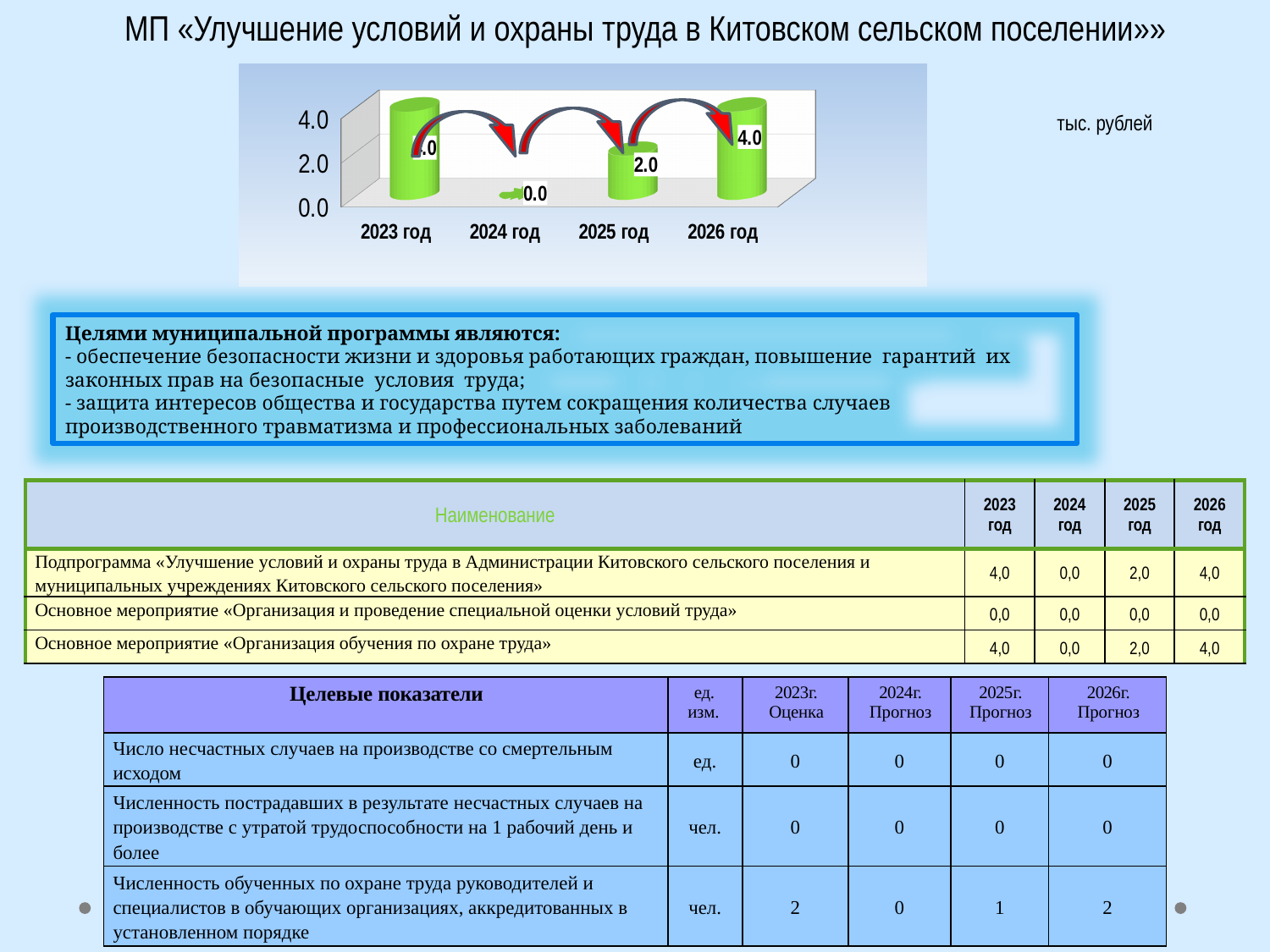
Which is larger, the value for 2025 год or the value for 2026 год? 2026 год What is the value for 2025 год on the chart? 2.0 How many years (categories) are plotted on the chart? 4 What is the value for 2026 год on the chart? 4.0 Which year has the lowest value on the chart? 2024 год What unit of measurement is indicated next to the chart? тыс. рублей Is the value for 2026 год greater or less than 2.0? greater Do the values rise or fall from 2024 год to 2026 год? rise What kind of chart is shown on the slide? bar chart What is the value for 2023 год on the chart? 4.0 What is the value for 2024 год on the chart? 0.0 What is the difference between the values for 2026 год and 2025 год? 2.0